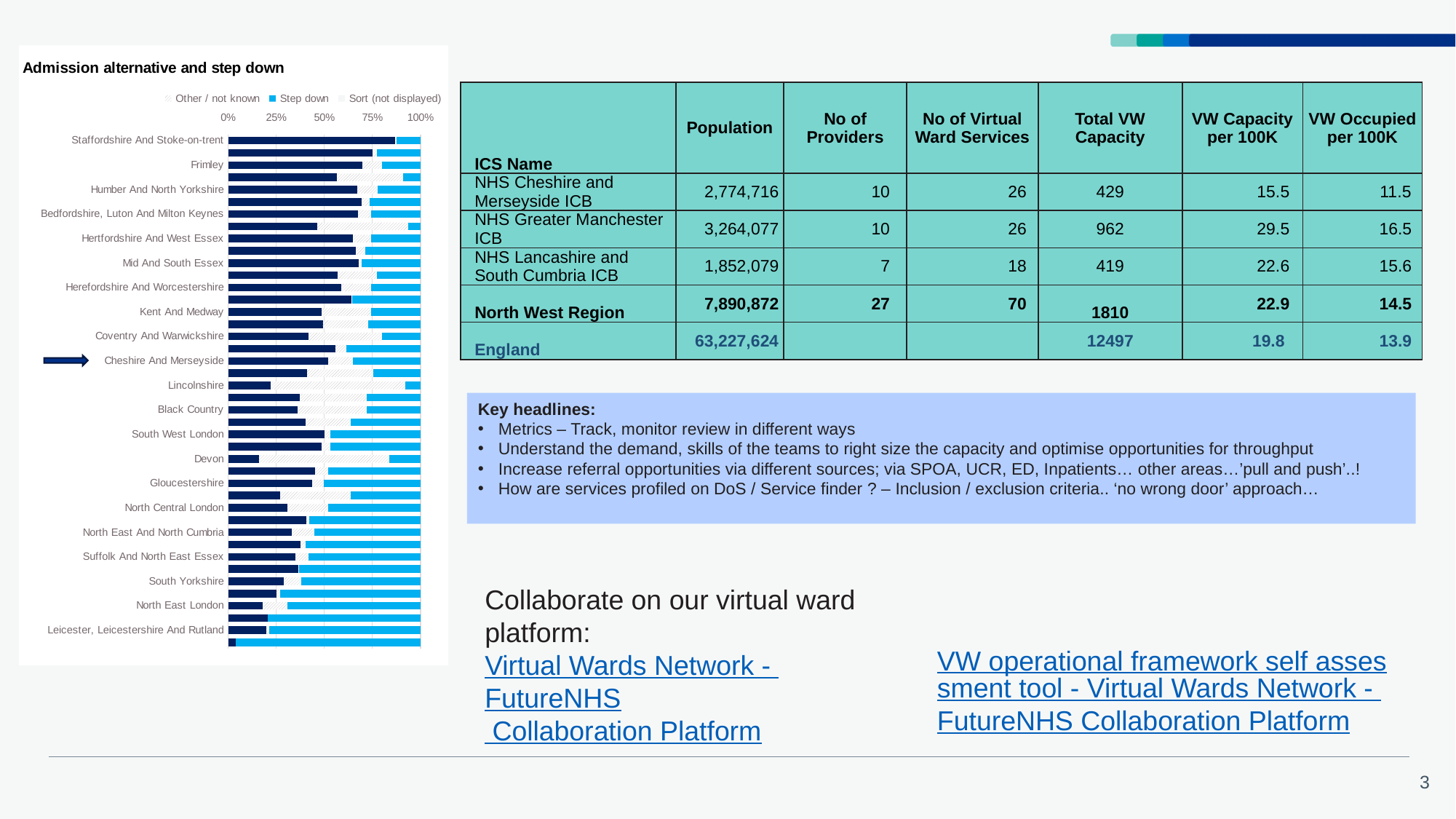
Is the 'Step down' share for Staffordshire And Stoke-on-trent greater or less than 25%? less Is the 'Other / not known' share for Leicester, Leicestershire And Rutland greater or less than 25%? less Is the 'Other / not known' share for Devon greater or less than 25%? greater Which is larger, the 'Step down' share for Leicester, Leicestershire And Rutland or for Staffordshire And Stoke-on-trent? Leicester, Leicestershire And Rutland What is the title of the chart on the slide? Admission alternative and step down How many series does the chart's legend list? 3 What kind of chart is shown on the slide? bar chart Which legend entry is shown in light blue in the chart? Step down Which is larger, the 'Other / not known' share for Staffordshire And Stoke-on-trent or for Devon? Devon